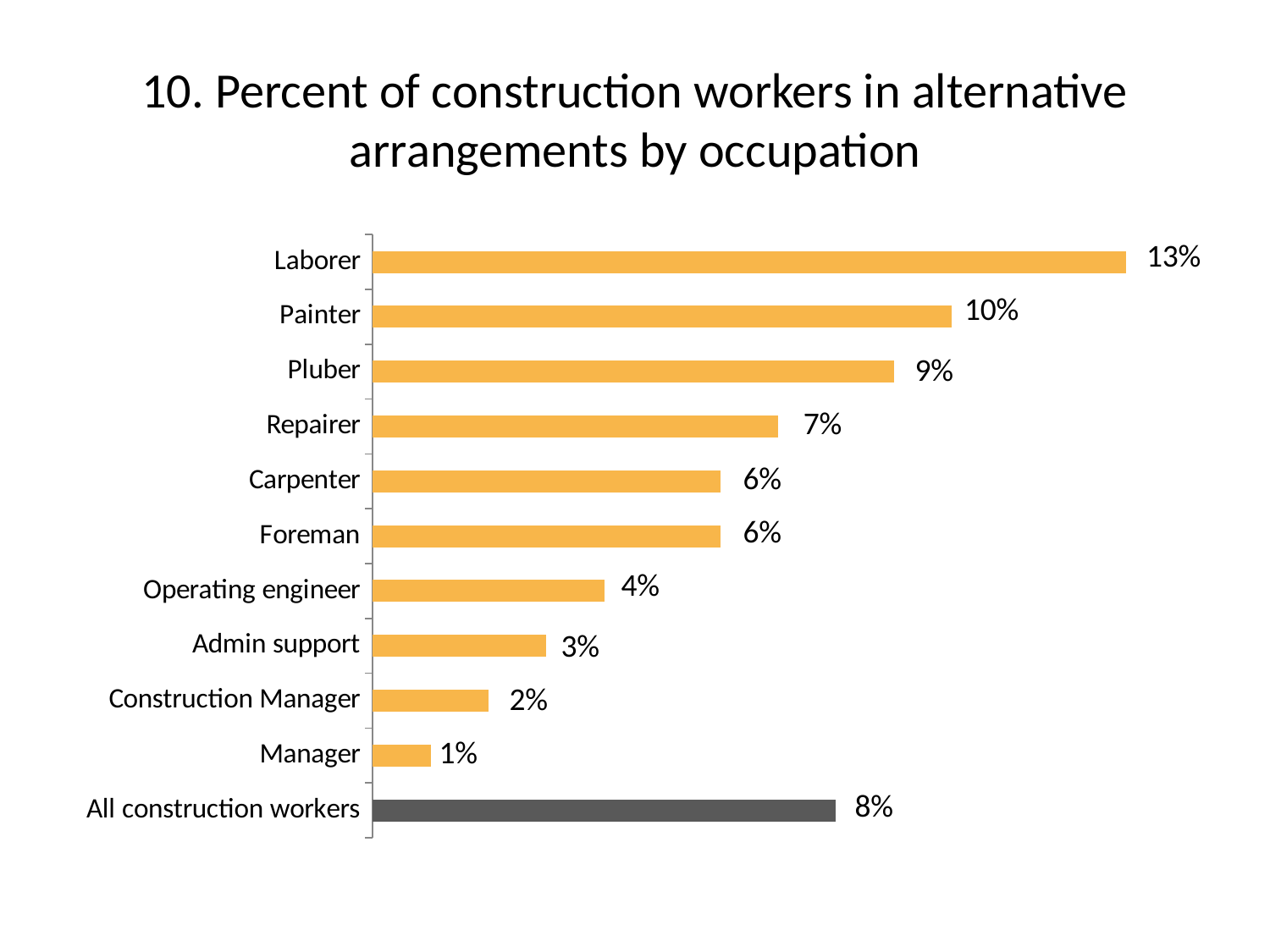
Which occupation has the lowest percentage? Manager How many categories are shown on the chart? 11 Which is larger, the value for Pluber or the value for Carpenter? Pluber What is the title of the chart? 10. Percent of construction workers in alternative arrangements by occupation What is the difference between the values for Painter and Repairer? 3% What kind of chart is shown on the slide? Bar chart Which bar is shown in a different colour (grey) from the others? All construction workers Which occupation has the highest percentage? Laborer What is the difference between the values for Laborer and All construction workers? 5% What is the value for Laborer? 13% What is the value for All construction workers? 8% What is the value for Operating engineer? 4%